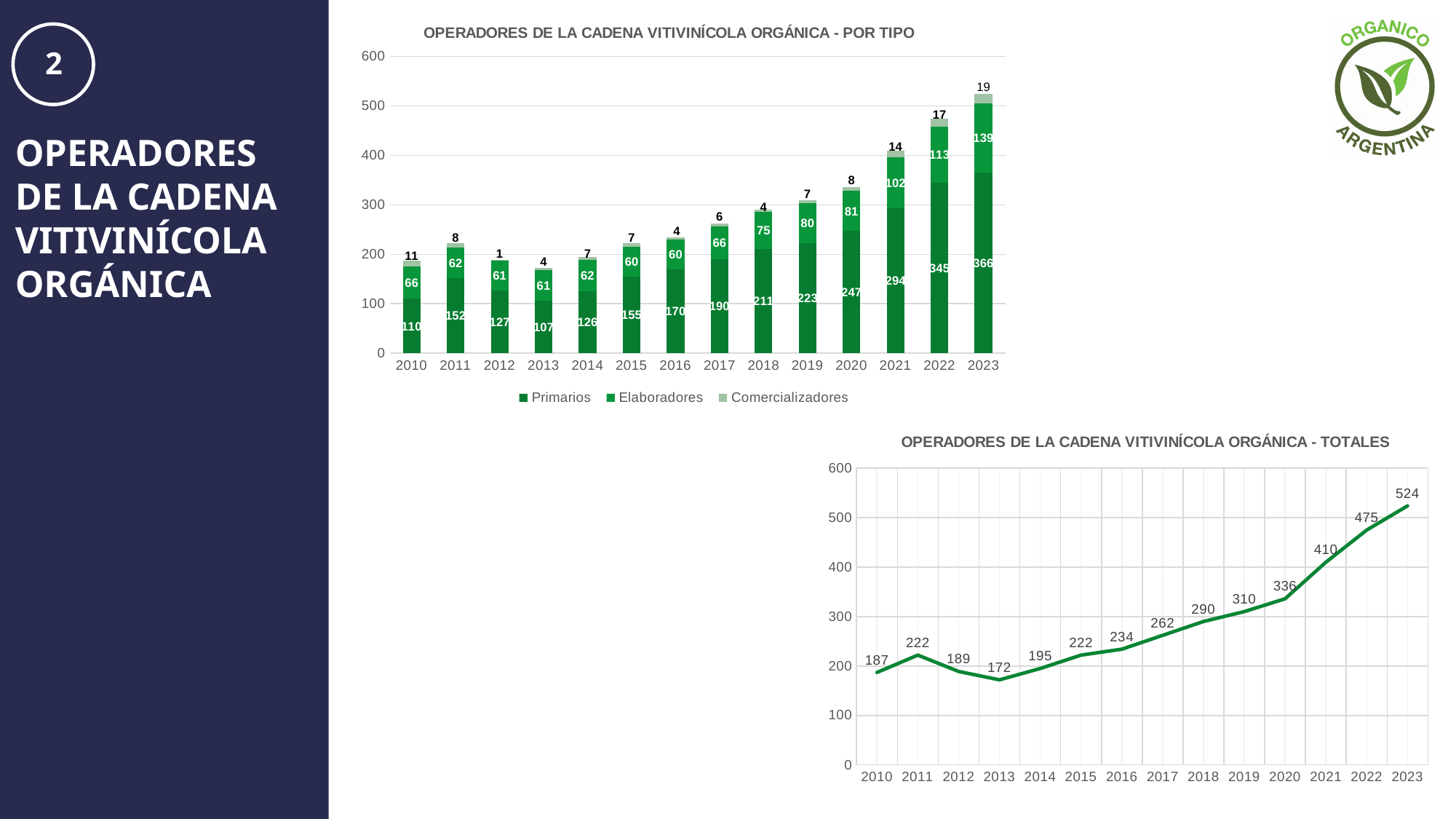
In the 'POR TIPO' chart, what is the value for Primarios in 2023? 366 In the 'TOTALES' chart, how many years are plotted on the x axis? 14 What kind of chart is the 'TOTALES' chart? Line chart In the 'TOTALES' chart, which year has the lowest value? 2013 In the 'POR TIPO' chart, how many series does the legend list? 3 In the 'POR TIPO' chart, what is the total of the stacked bar for 2021? 410 In the 'POR TIPO' chart, what is the difference between the Primarios values for 2022 and 2021? 51 In the 'POR TIPO' chart, what is the value for Elaboradores in 2017? 66 In the 'POR TIPO' chart, which year has the highest Comercializadores value? 2023 In the 'TOTALES' chart, what is the value for 2013? 172 In the 'POR TIPO' chart, what is the value for Comercializadores in 2012? 1 In the 'TOTALES' chart, is the value for 2020 greater or less than 300? greater